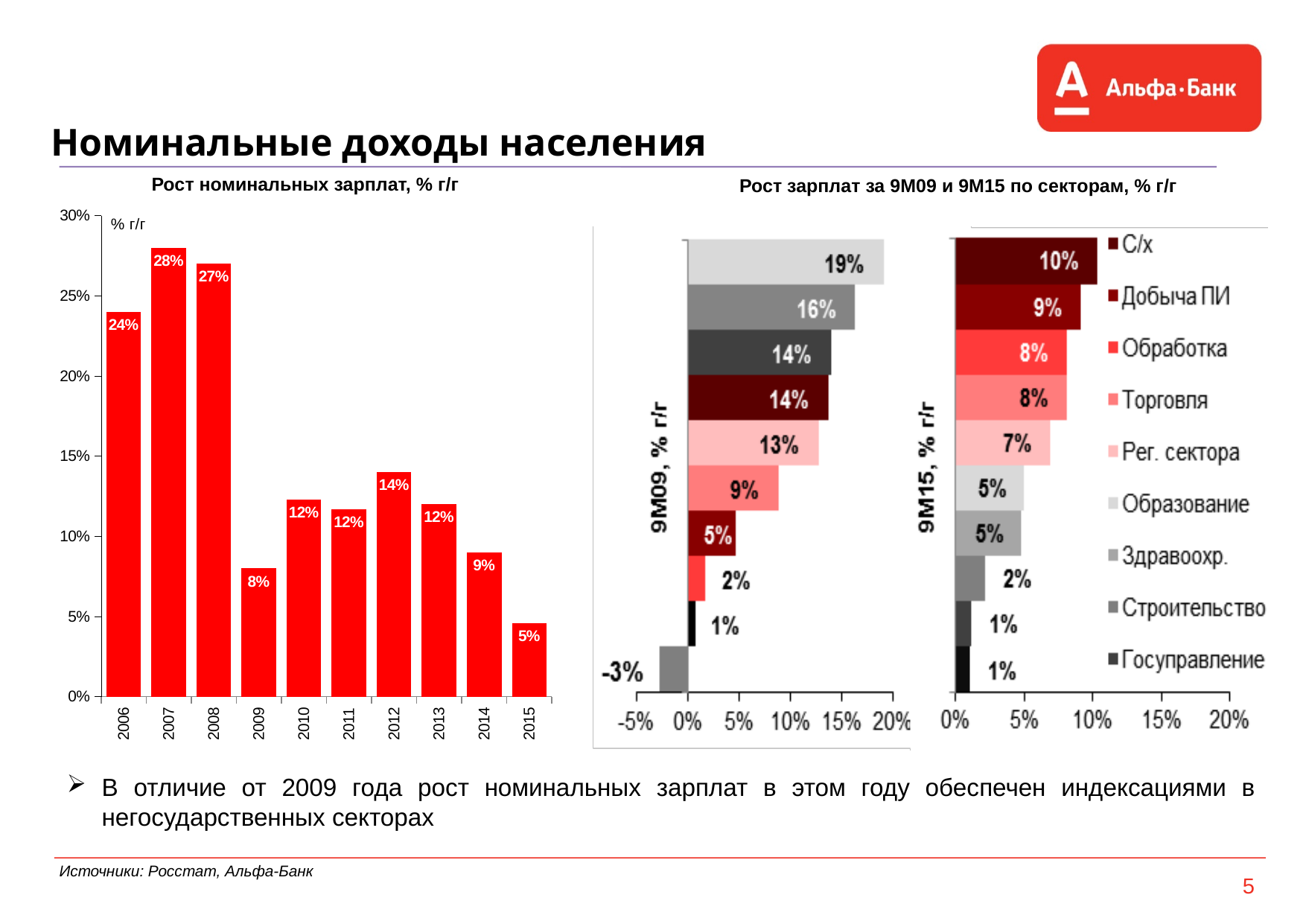
How many sectors does the legend of the chart 'Рост зарплат за 9М09 и 9М15 по секторам, % г/г' list? 9 In the chart 'Рост номинальных зарплат, % г/г', what is the value for 2007? 28% In the chart 'Рост номинальных зарплат, % г/г', which year has the highest value? 2007 In the chart 'Рост зарплат за 9М09 и 9М15 по секторам, % г/г', what is the highest value shown in the 9М09 panel? 19% How many years are shown in the chart 'Рост номинальных зарплат, % г/г'? 10 In the chart 'Рост номинальных зарплат, % г/г', what is the difference between the values for 2008 and 2009? 19% In the chart 'Рост номинальных зарплат, % г/г', which is larger, the value for 2012 or the value for 2014? 2012 In the chart 'Рост зарплат за 9М09 и 9М15 по секторам, % г/г', what is the lowest value shown in the 9М09 panel? -3% In the chart 'Рост номинальных зарплат, % г/г', what is the value for 2009? 8% In the chart 'Рост номинальных зарплат, % г/г', which year has the lowest value? 2015 In the chart 'Рост номинальных зарплат, % г/г', what is the value for 2015? 5% What type of chart is 'Рост номинальных зарплат, % г/г'? Bar chart